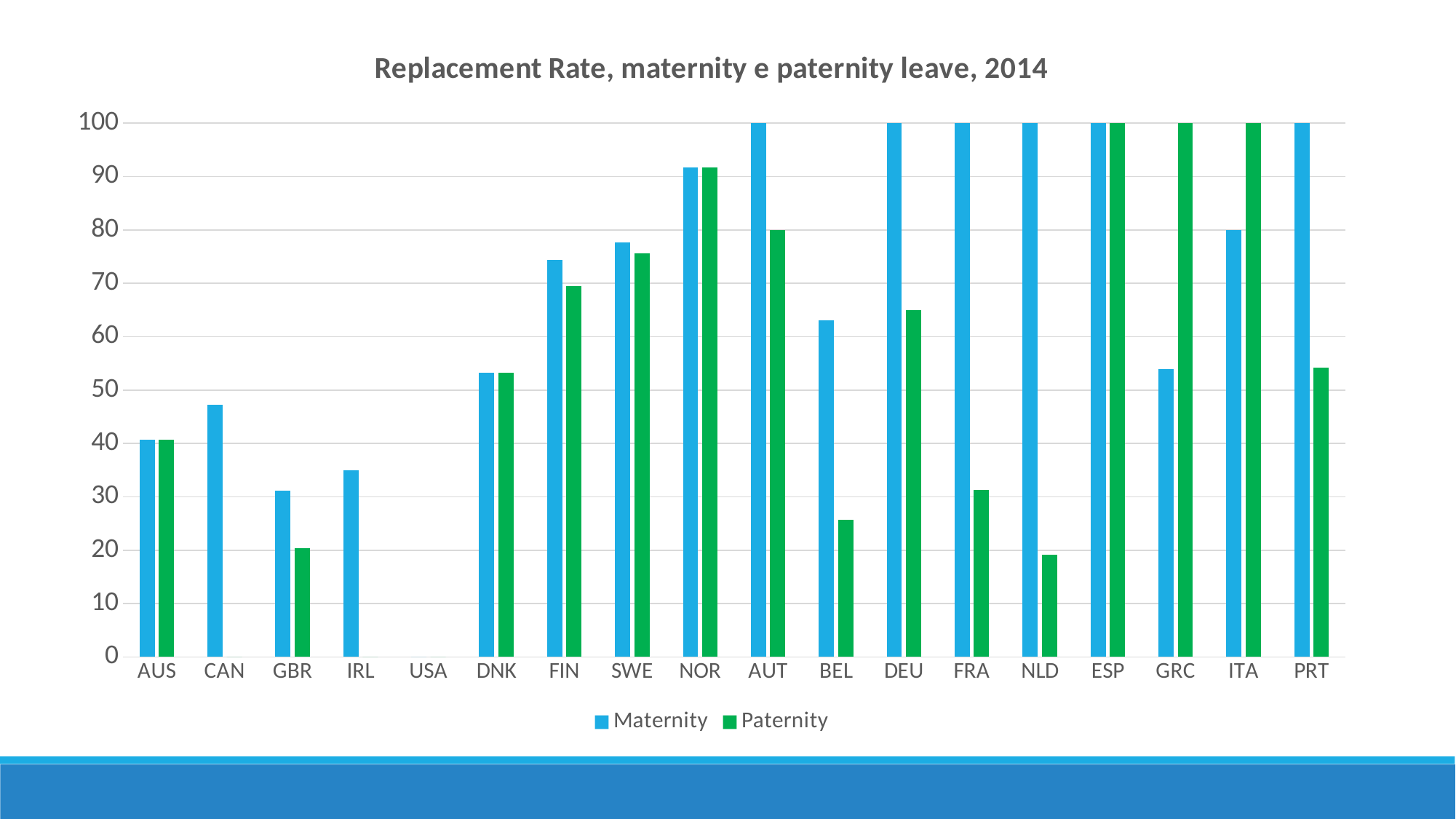
For GBR, which is larger, the Maternity value or the Paternity value? Maternity What type of chart is shown on the slide? bar chart How many countries are shown on the x axis? 18 Is the Maternity value for CAN greater or less than 50? less Is the Paternity value for BEL greater or less than 20? greater What is the Paternity value for GRC? 100 What is the title of the chart? Replacement Rate, maternity e paternity leave, 2014 What is the Maternity value for ITA? 80 What is the Maternity value for ESP? 100 What is the difference between the Maternity and Paternity values for AUT? 20 How many series does the legend list? 2 What is the Paternity value for AUT? 80